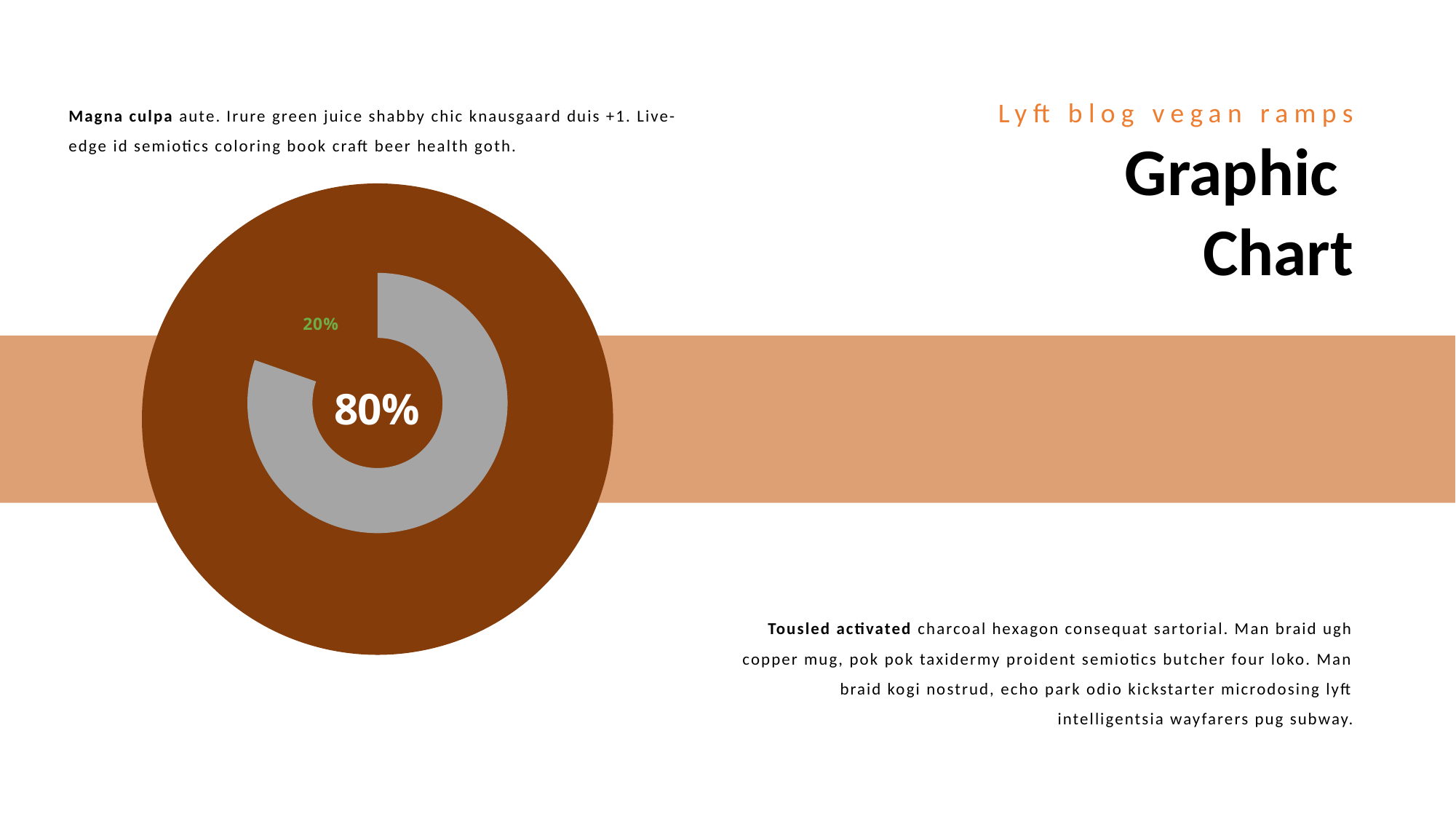
What kind of chart is shown on the slide? doughnut chart What is the difference between the two slice values in the doughnut chart? 60% What value is labelled on the brown slice of the doughnut chart? 20% What is the title shown on the slide next to the chart? Graphic Chart Which is larger in the doughnut chart, the grey slice or the brown slice? the grey slice How many slices does the doughnut chart have? 2 What colour is the slice labelled 20% in the doughnut chart? brown What value is labelled on the grey slice of the doughnut chart? 80% What do the two slice values in the doughnut chart add up to? 100% Which slice of the doughnut chart is the largest? the grey slice (80%) Which slice of the doughnut chart is the smallest? the brown slice (20%) What share of the doughnut chart does the grey slice represent? 80%